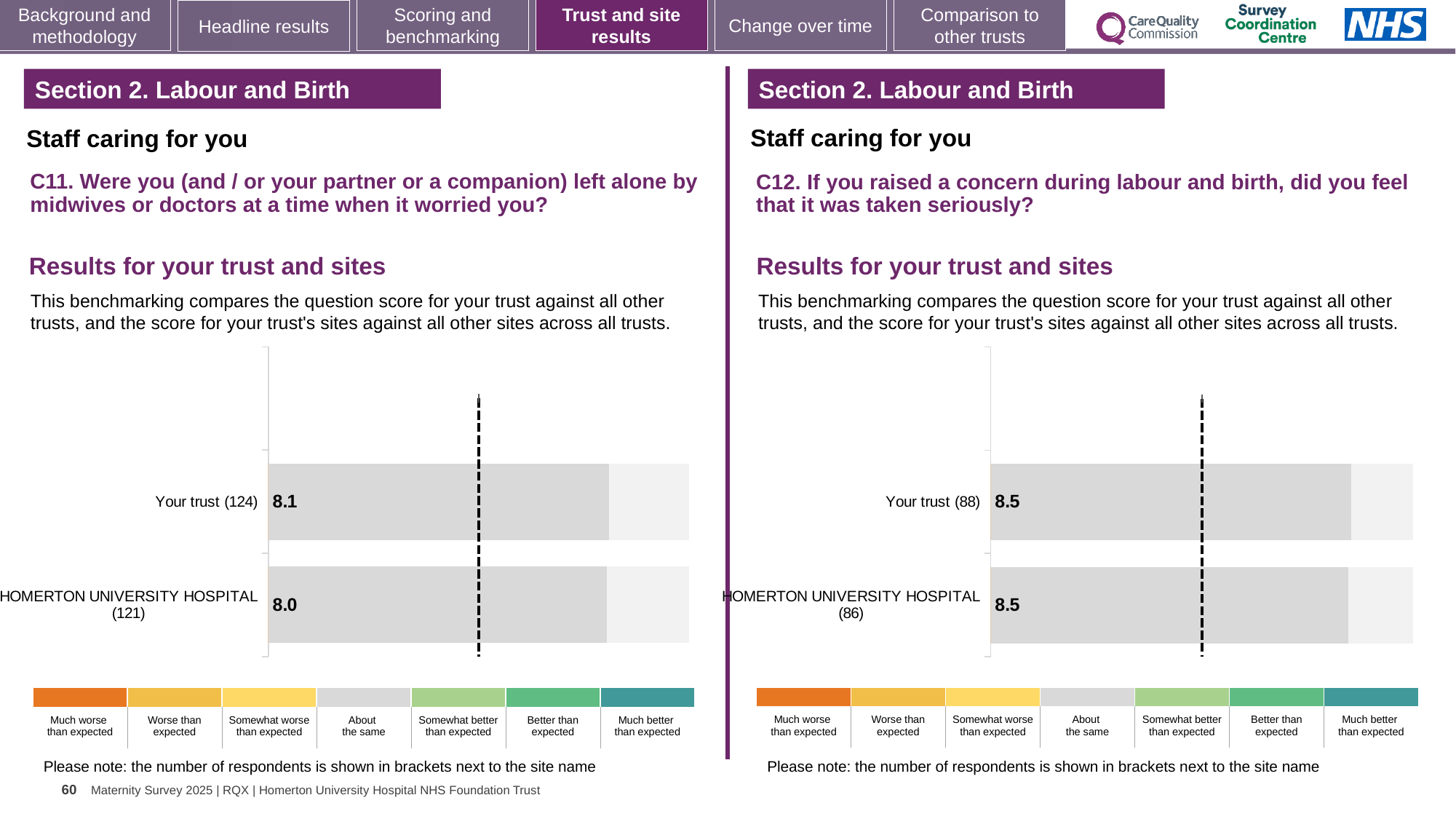
What type of chart is used for the C11 results on the left? Bar chart In the C11 chart on the left, what is the score for Homerton University Hospital (121)? 8.0 In the C12 chart on the right, what is the score for Your trust (88)? 8.5 How many bars are plotted in the C12 chart on the right? 2 In the C11 chart on the left, what is the score for Your trust (124)? 8.1 In the C11 chart on the left, which category has the lowest score? Homerton University Hospital (121) In the C12 chart on the right, how many respondents are shown in brackets for Your trust? 88 In the C12 chart on the right, what is the score for Homerton University Hospital (86)? 8.5 In the C11 chart on the left, what is the difference between the score for Your trust and the score for Homerton University Hospital? 0.1 How many benchmark categories are listed in the colour key below the C11 chart on the left? 7 In the C11 chart on the left, which has the higher score: Your trust or Homerton University Hospital? Your trust